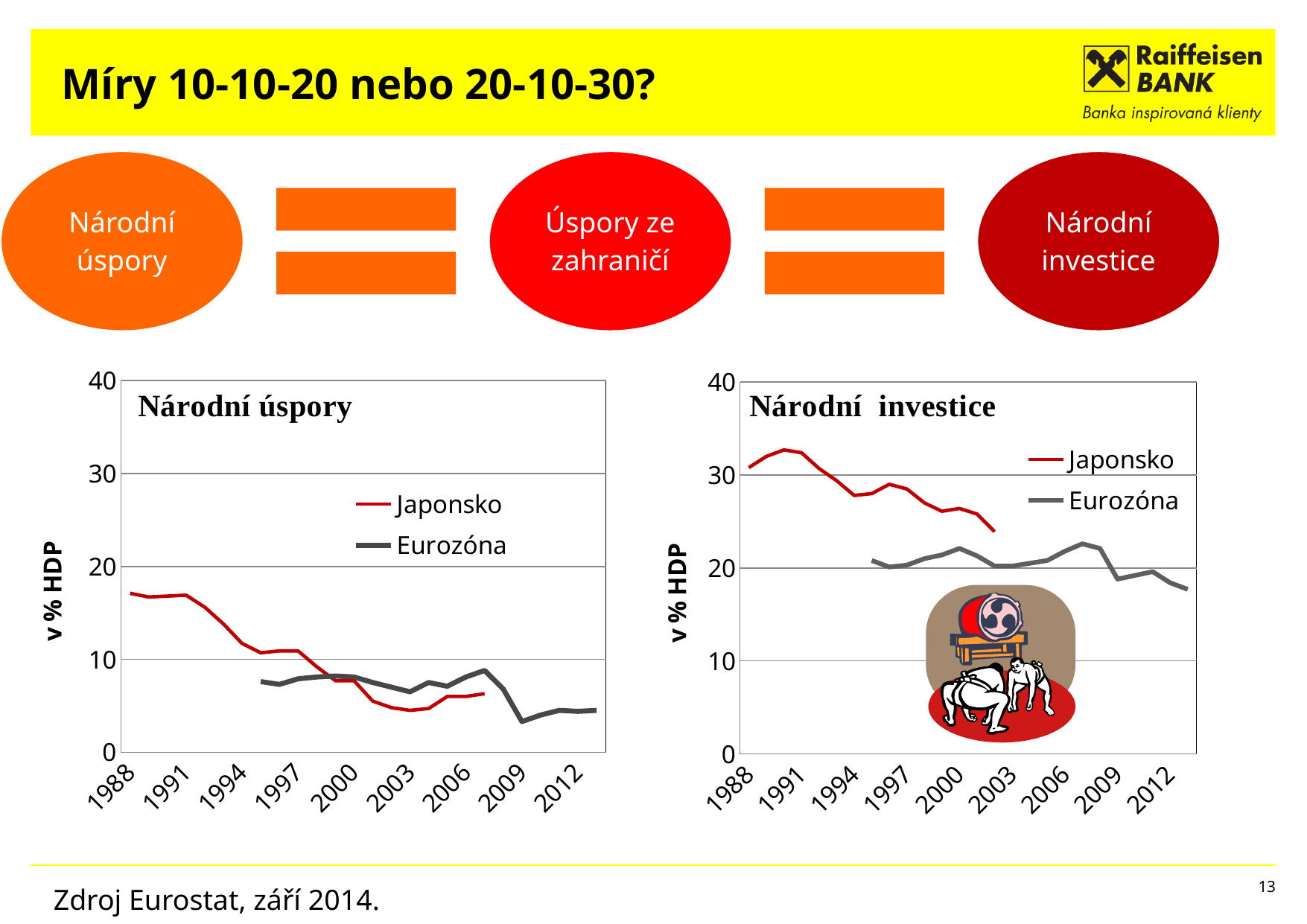
In the 'Národní investice' chart, is the value for Eurozóna in 2012 greater or less than 20? less In the 'Národní úspory' chart, does the Japonsko line generally rise or fall from 1988 to 2003? fall In the 'Národní úspory' chart, is the value for Eurozóna in 2009 greater or less than 10? less In the 'Národní investice' chart, which series has the higher value in 1997, Japonsko or Eurozóna? Japonsko In the 'Národní investice' chart, is the value for Japonsko in 2002 greater or less than 20? greater In the 'Národní investice' chart, does the Japonsko line generally rise or fall from 1991 to 2002? fall How many series does the legend of the 'Národní investice' chart list? 2 What kind of chart is the 'Národní úspory' chart? line chart In the 'Národní úspory' chart, which series has the higher value in 2003, Japonsko or Eurozóna? Eurozóna What is the label on the vertical axis of the 'Národní úspory' chart? v % HDP